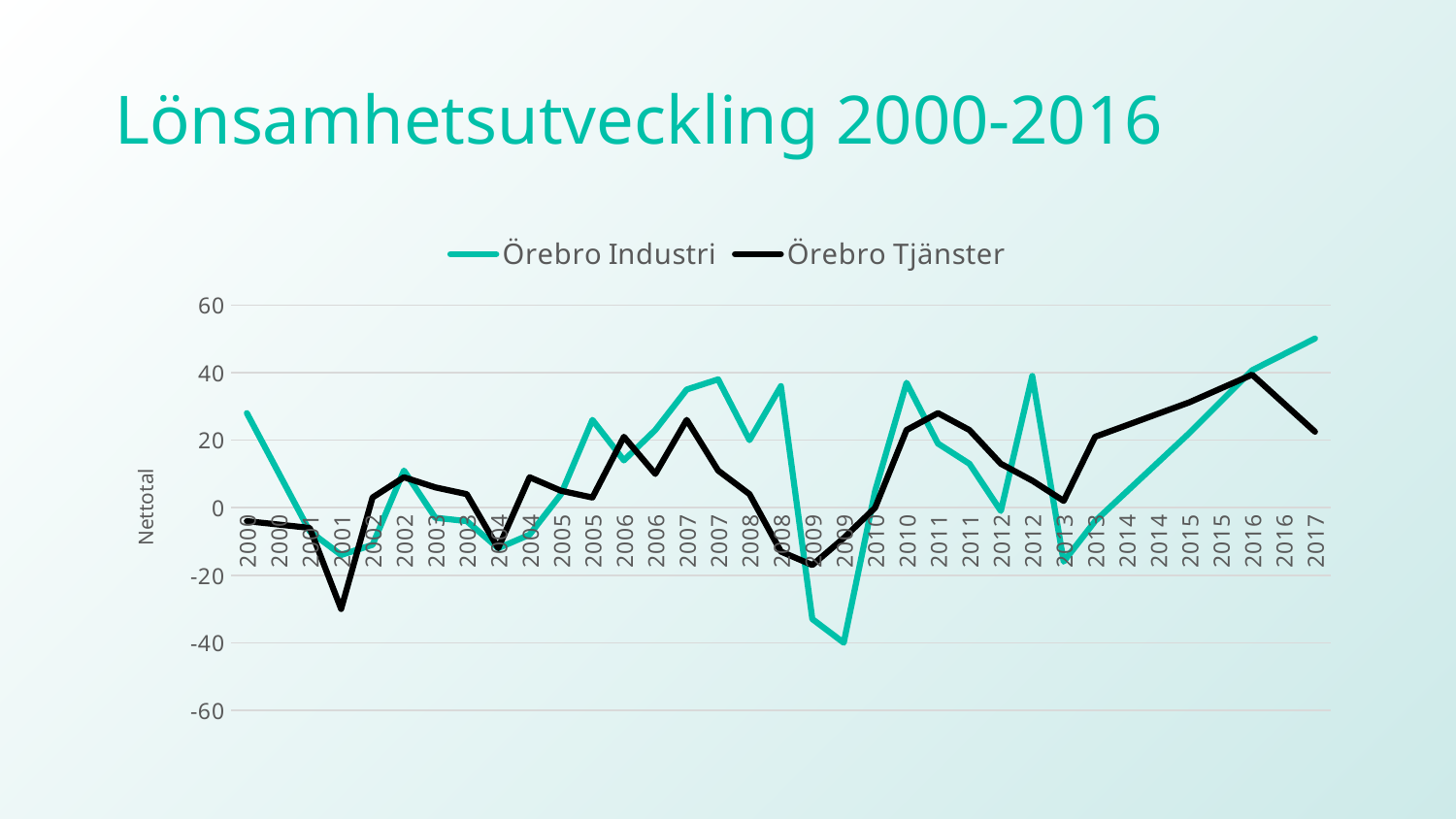
How many series does the legend list? 2 Is the value for Örebro Tjänster at 2017 greater or less than 0? greater What is the title of the chart on the slide? Lönsamhetsutveckling 2000-2016 Is the value for Örebro Industri at the first 2009 point greater or less than -20? less At which x-axis label does Örebro Tjänster reach its lowest value? 2001 (second point) Does the Örebro Tjänster line rise or fall between the second 2013 point and the second 2016 point? Rise What kind of chart is shown on the slide? Line chart At 2017, which series has the larger value, Örebro Industri or Örebro Tjänster? Örebro Industri Is the value for Örebro Tjänster at the first 2001 point greater or less than -20? greater What is the label on the vertical axis? Nettotal At which x-axis label does Örebro Industri reach its highest value? 2017